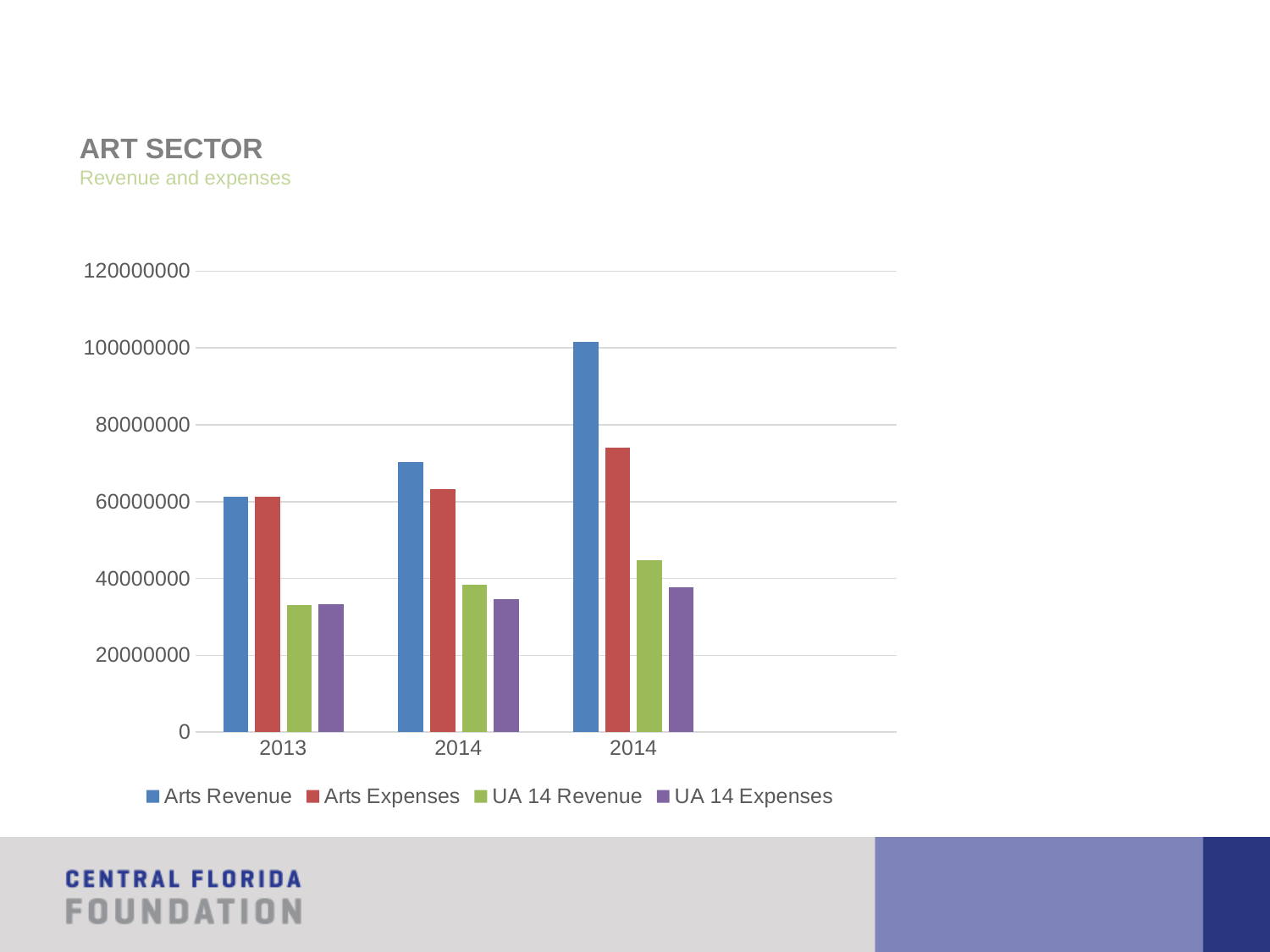
Is the Arts Revenue value for the rightmost group (2014) greater or less than 100000000? greater Which series has the shortest bar in the middle group (2014)? UA 14 Expenses What kind of chart is shown on the slide? bar chart In the rightmost group (2014), which is larger: Arts Revenue or Arts Expenses? Arts Revenue Which series has the tallest bar in the rightmost group (2014)? Arts Revenue How many series does the legend list? 4 What is the subtitle shown under the slide title 'ART SECTOR'? Revenue and expenses Is the Arts Revenue value for 2013 greater or less than 80000000? less How many category groups are shown along the x axis? 3 Does the Arts Revenue series rise or fall from left to right across the groups? rise Is the Arts Expenses value for the rightmost group (2014) greater or less than 60000000? greater